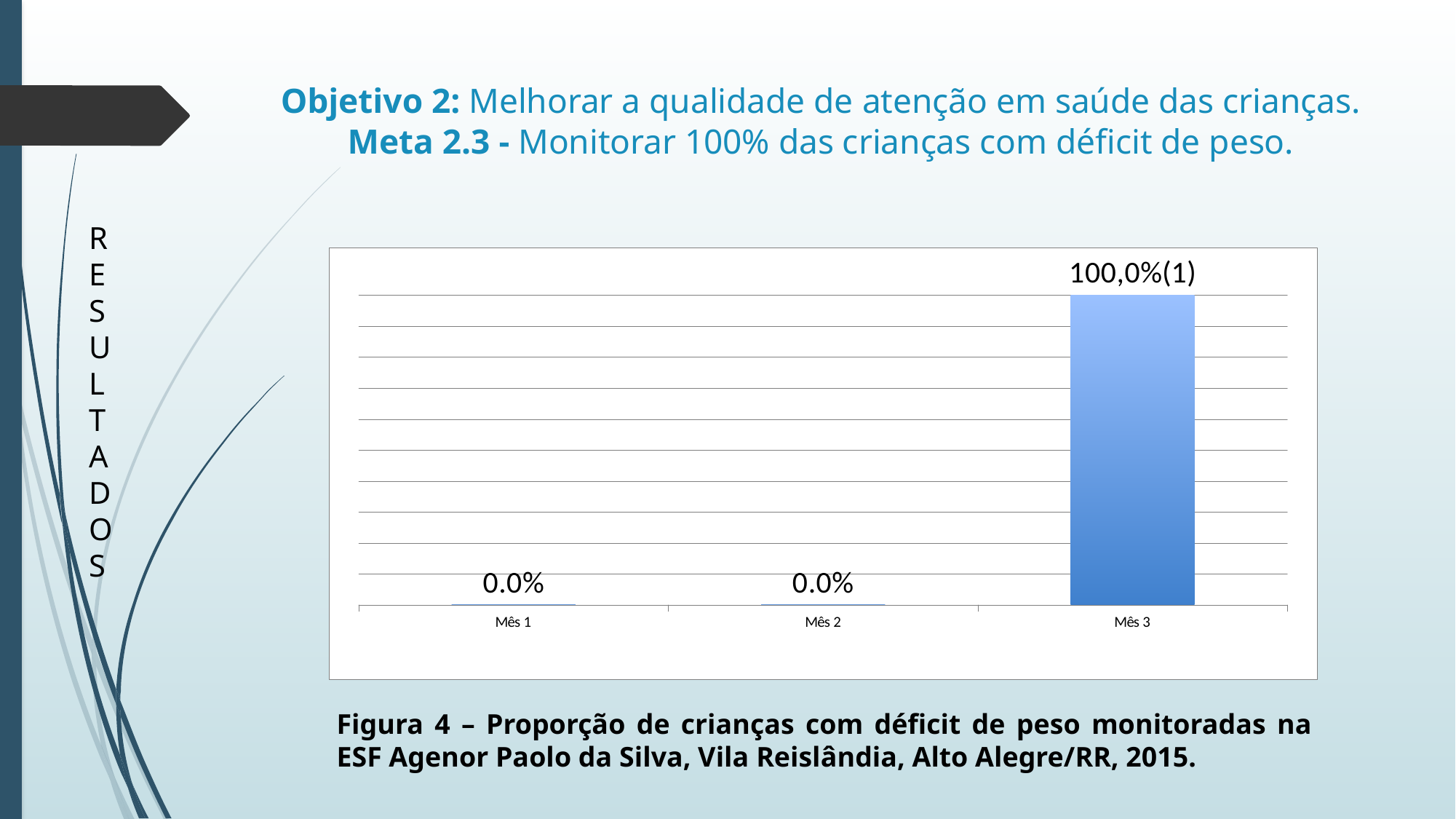
What is the difference between the values for Mês 3 and Mês 1? 100,0% Which of Mês 2 and Mês 3 has the larger value? Mês 3 What is the value for Mês 3? 100,0%(1) Do the values rise or fall from Mês 1 to Mês 3? Rise What is the label of the last category on the x axis? Mês 3 What kind of chart is shown? Bar chart What is the value for Mês 2? 0.0% Which month has the highest value? Mês 3 How many months are shown on the x axis? 3 What is the value for Mês 1? 0.0% What is the figure number given in the caption below the chart? Figura 4